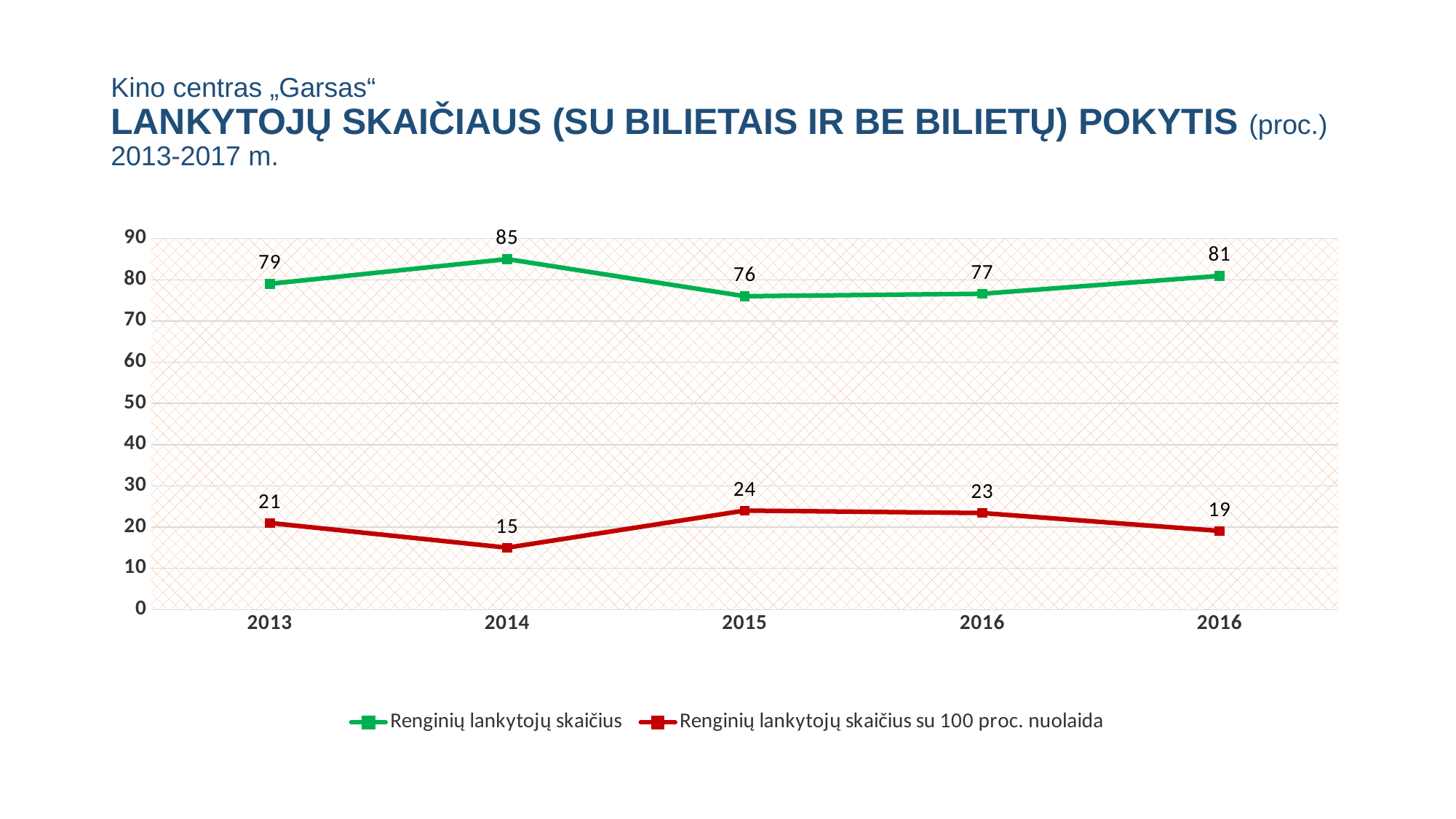
Does "Renginių lankytojų skaičius" rise or fall from 2014 to 2015? Fall How many data points does each series have? 5 What is the value of "Renginių lankytojų skaičius su 100 proc. nuolaida" in 2013? 21 In which year is "Renginių lankytojų skaičius su 100 proc. nuolaida" at its lowest? 2014 Which series has the larger value in 2013, "Renginių lankytojų skaičius" or "Renginių lankytojų skaičius su 100 proc. nuolaida"? Renginių lankytojų skaičius What is the difference between the two series in 2015? 52 What kind of chart is shown on the slide? Line chart What is the value of "Renginių lankytojų skaičius" in 2014? 85 How many series does the legend list? 2 In which year does "Renginių lankytojų skaičius" reach its highest value? 2014 What is the value of "Renginių lankytojų skaičius su 100 proc. nuolaida" in 2014? 15 What is the value of "Renginių lankytojų skaičius" in 2015? 76